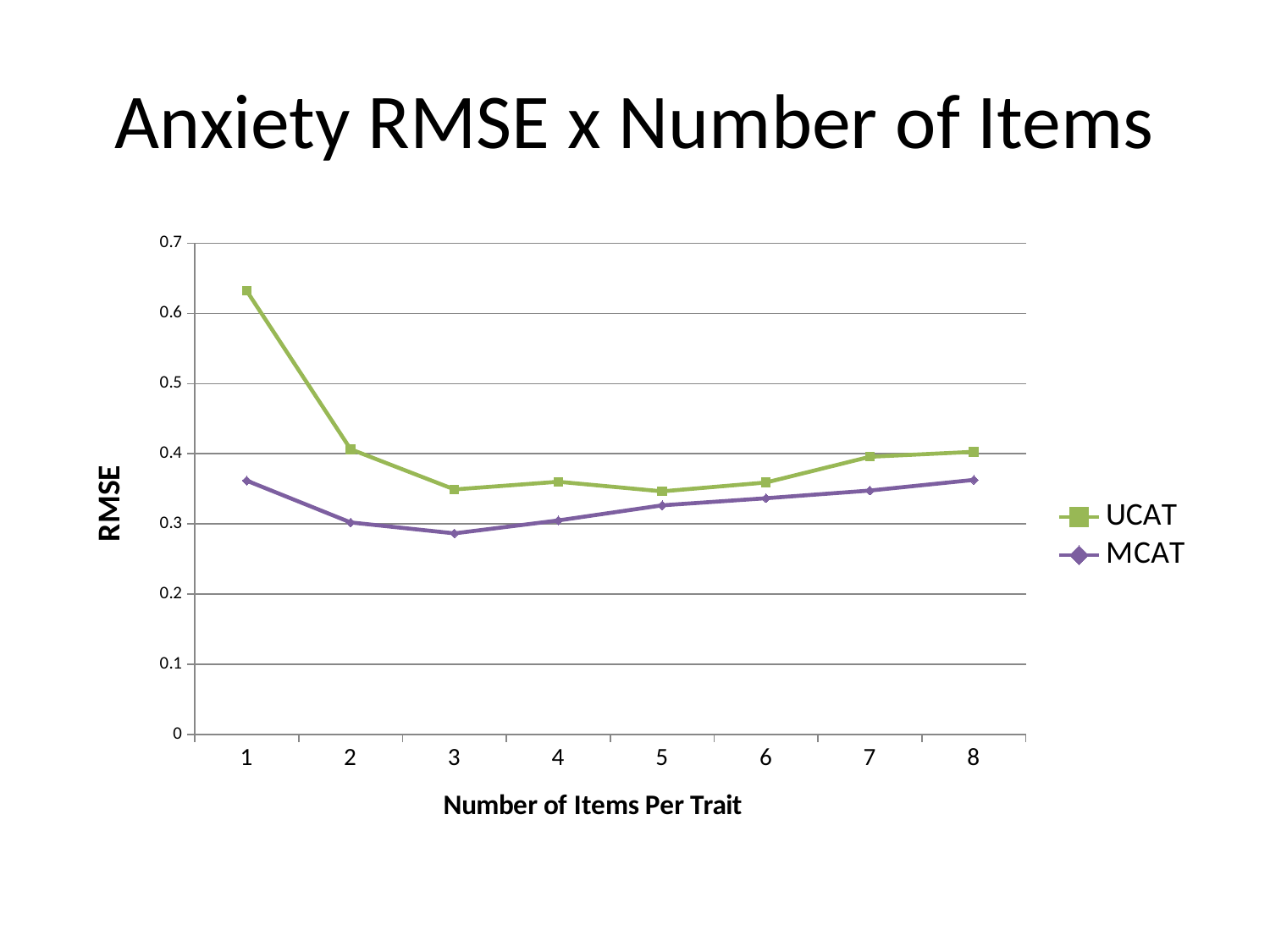
Is the MCAT value at 3 items per trait greater or less than 0.3? less Is the UCAT value at 1 item per trait greater or less than 0.6? greater What kind of chart is shown on the slide? line chart At 1 item per trait, which series has the larger RMSE, UCAT or MCAT? UCAT How many points are plotted along the x axis for each series? 8 What is the label of the x axis? Number of Items Per Trait How many series does the legend list? 2 Does the UCAT RMSE rise or fall from 1 to 3 items per trait? fall Is the MCAT value at 1 item per trait greater or less than 0.4? less At which number of items per trait is the UCAT RMSE highest? 1